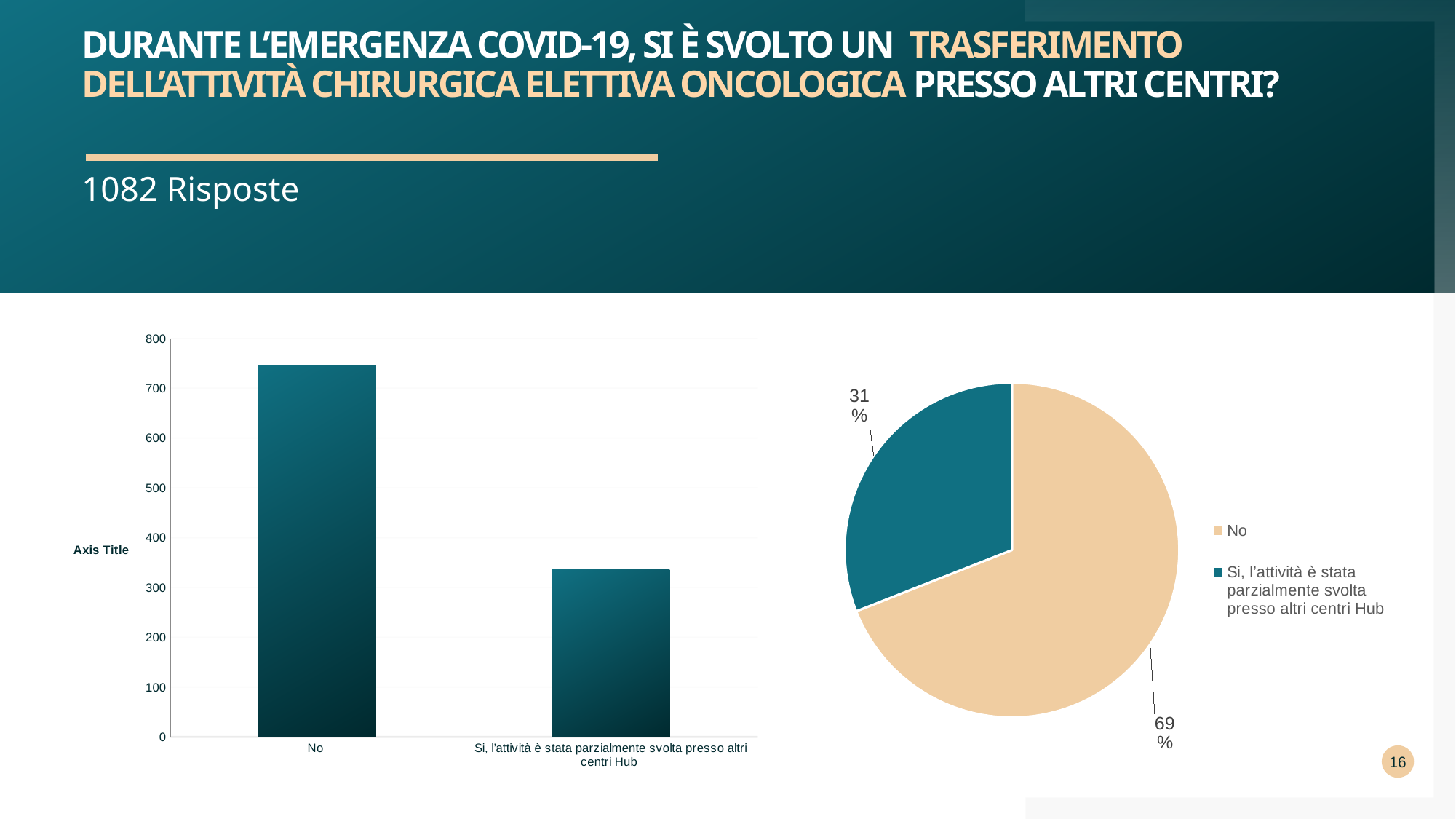
In the bar chart on the left, is the value for "Si, l'attività è stata parzialmente svolta presso altri centri Hub" greater or less than 300? greater In the bar chart on the left, is the value for "Si, l'attività è stata parzialmente svolta presso altri centri Hub" greater or less than 400? less What kind of chart is the chart on the left of the slide? bar chart In the bar chart on the left, which category has the lowest bar? Si, l'attività è stata parzialmente svolta presso altri centri Hub How many entries does the legend of the pie chart on the right list? 2 In the pie chart on the right, what share of the pie is labelled "Si, l'attività è stata parzialmente svolta presso altri centri Hub"? 31% In the bar chart on the left, which category has the highest bar? No In the pie chart on the right, what is the difference in percentage points between the "No" slice and the "Si" slice? 38% In the bar chart on the left, is the value for "No" greater or less than 700? greater In the bar chart on the left, how many categories are shown on the x axis? 2 In the pie chart on the right, what share of the pie is labelled "No"? 69% What kind of chart is the chart on the right of the slide? pie chart